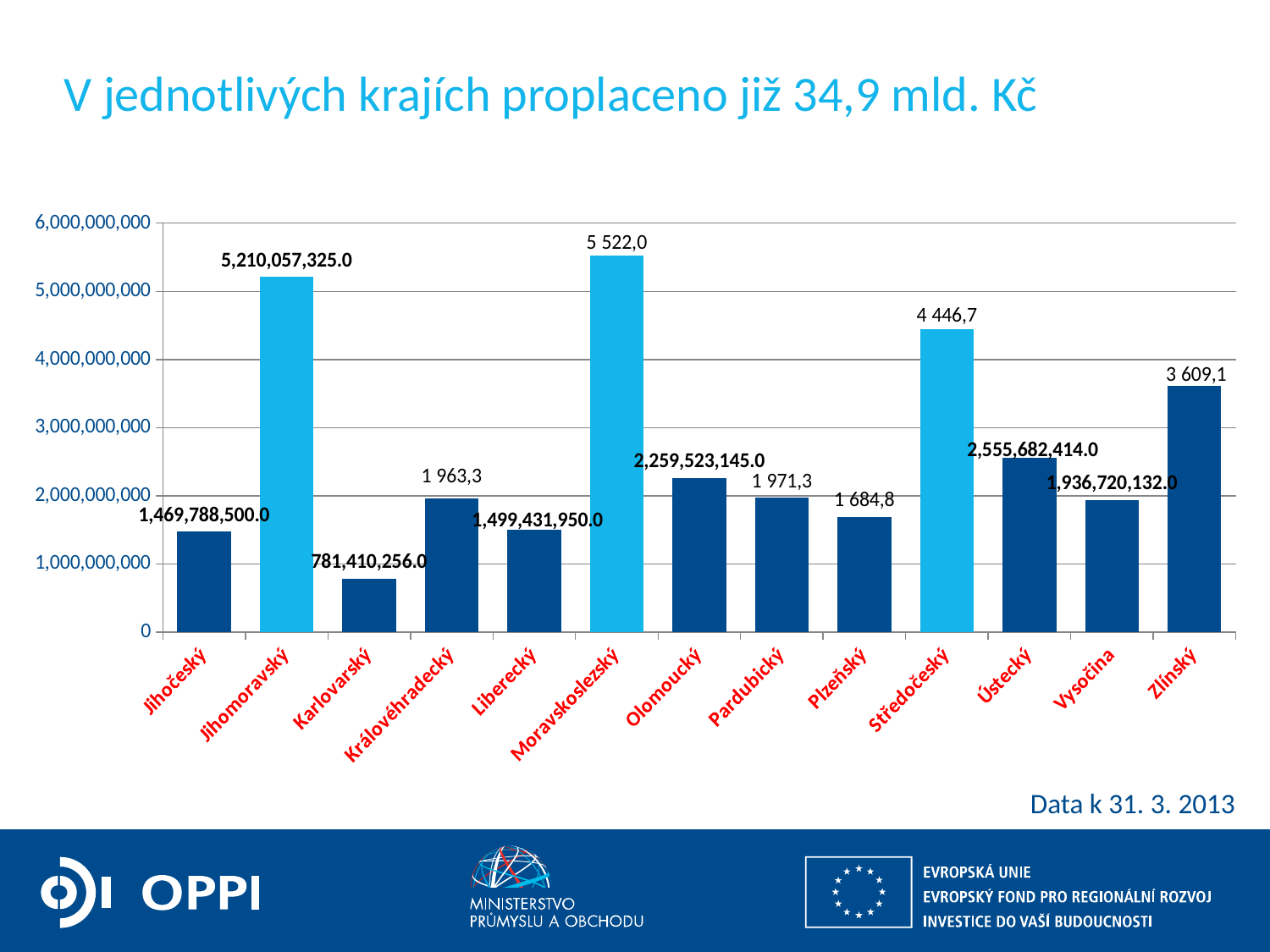
Is the value for Plzeňský greater or less than 2,000,000,000? less What value is shown for Karlovarský? 781,410,256.0 How many regions are shown on the x axis? 13 What kind of chart is shown on the slide? bar chart Which regions are drawn in the lighter blue colour? Jihomoravský, Moravskoslezský, Středočeský What data label is shown above the Moravskoslezský bar? 5 522,0 What data label is shown above the Zlínský bar? 3 609,1 Which region has the highest bar? Moravskoslezský Which is larger, the value for Středočeský or the value for Zlínský? Středočeský What value is shown for Jihomoravský? 5,210,057,325.0 Which region has the lowest bar? Karlovarský What is the difference between the values for Ústecký and Olomoucký? 296,159,269.0